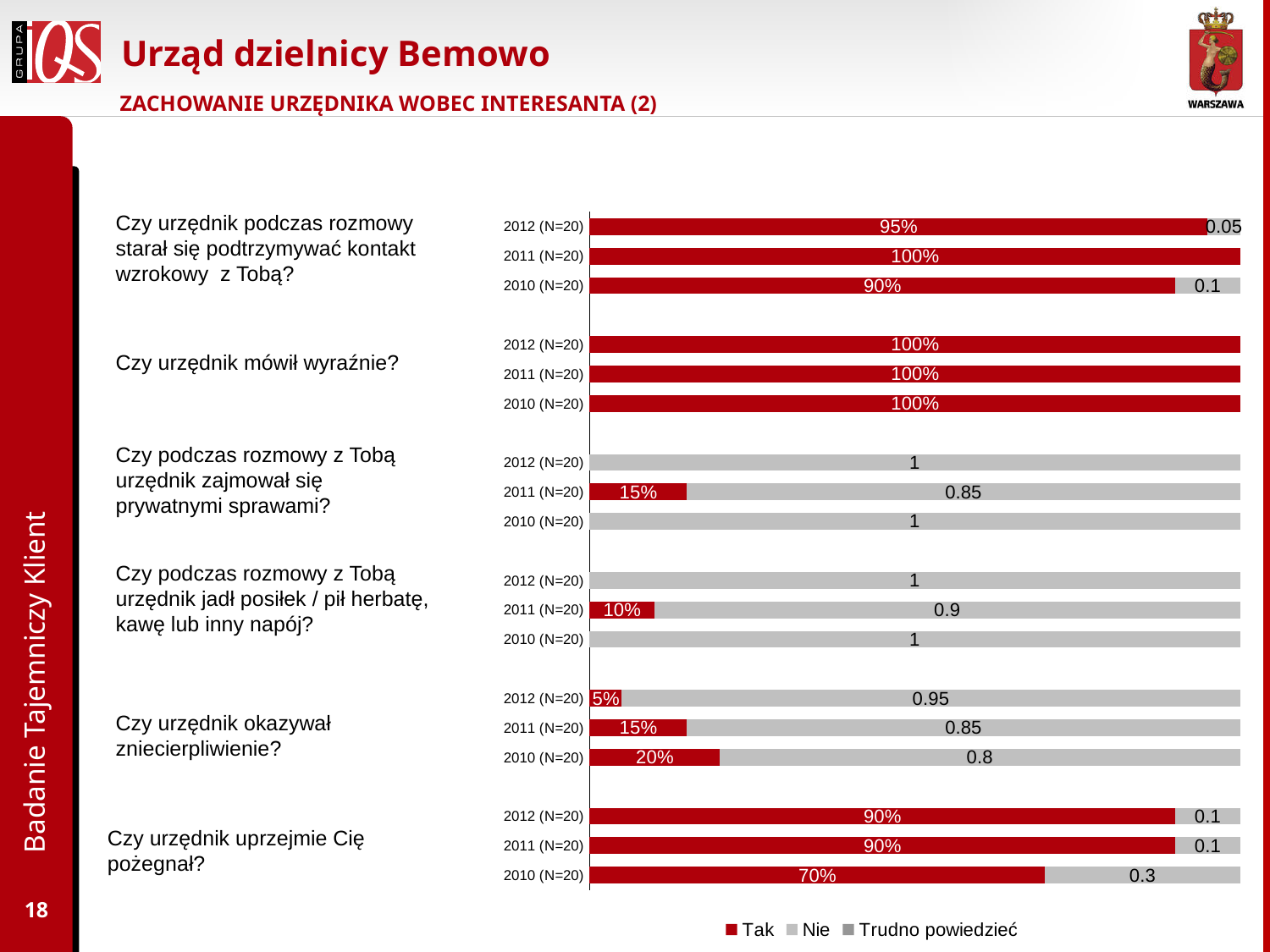
For the question 'Czy urzędnik uprzejmie Cię pożegnał?', is the 'Tak' value for 2012 (N=20) larger or smaller than for 2010 (N=20)? Larger For the question 'Czy urzędnik okazywał zniecierpliwienie?', what is the difference between the 'Tak' values for 2010 (N=20) and 2012 (N=20)? 15% For the question 'Czy podczas rozmowy z Tobą urzędnik jadł posiłek / pił herbatę, kawę lub inny napój?', what is the 'Nie' value for 2011 (N=20)? 0.9 For the question 'Czy urzędnik okazywał zniecierpliwienie?', which year has the highest 'Tak' value? 2010 (N=20) For the question 'Czy urzędnik mówił wyraźnie?', what is the 'Tak' value for 2011 (N=20)? 100% What type of chart is shown on the slide? Stacked bar chart For the question 'Czy urzędnik podczas rozmowy starał się podtrzymywać kontakt wzrokowy z Tobą?', what is the 'Nie' value for 2010 (N=20)? 0.1 How many series does the legend list? 3 What are the legend entries of the chart? Tak, Nie, Trudno powiedzieć For the question 'Czy podczas rozmowy z Tobą urzędnik zajmował się prywatnymi sprawami?', what is the 'Tak' value for 2011 (N=20)? 15% For the question 'Czy urzędnik podczas rozmowy starał się podtrzymywać kontakt wzrokowy z Tobą?', what is the 'Tak' value for 2012 (N=20)? 95% For the question 'Czy urzędnik uprzejmie Cię pożegnał?', which year has the lowest 'Tak' value? 2010 (N=20)